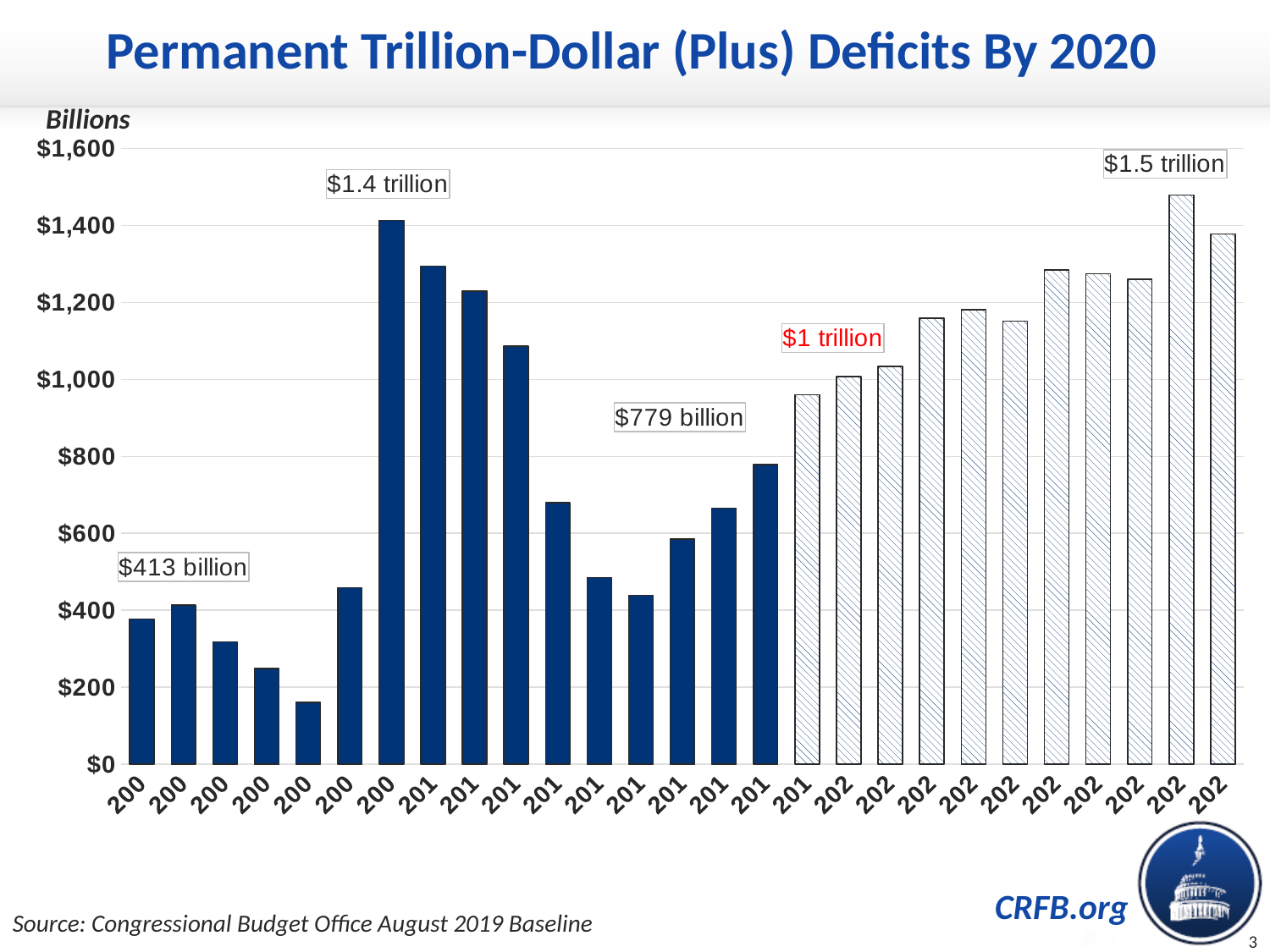
What value is labeled near the leftmost group of bars? $413 billion What is the title of the chart? Permanent Trillion-Dollar (Plus) Deficits By 2020 Which is larger, the bar labeled $1.4 trillion or the bar labeled $1.5 trillion? the bar labeled $1.5 trillion What value is labeled on the tallest hatched bar? $1.5 trillion Is the value of the lowest bar on the chart greater or less than $200? less What value is labeled on the tallest solid blue bar? $1.4 trillion What type of chart is shown on the slide? bar chart What value is labeled on the last solid blue bar before the hatched bars begin? $779 billion What unit label is shown above the y-axis? Billions Do the hatched bars on the right side of the chart generally rise or fall from left to right? rise What value is labeled on the first hatched bar, shown in red text? $1 trillion What is the highest value shown on the y-axis? $1,600